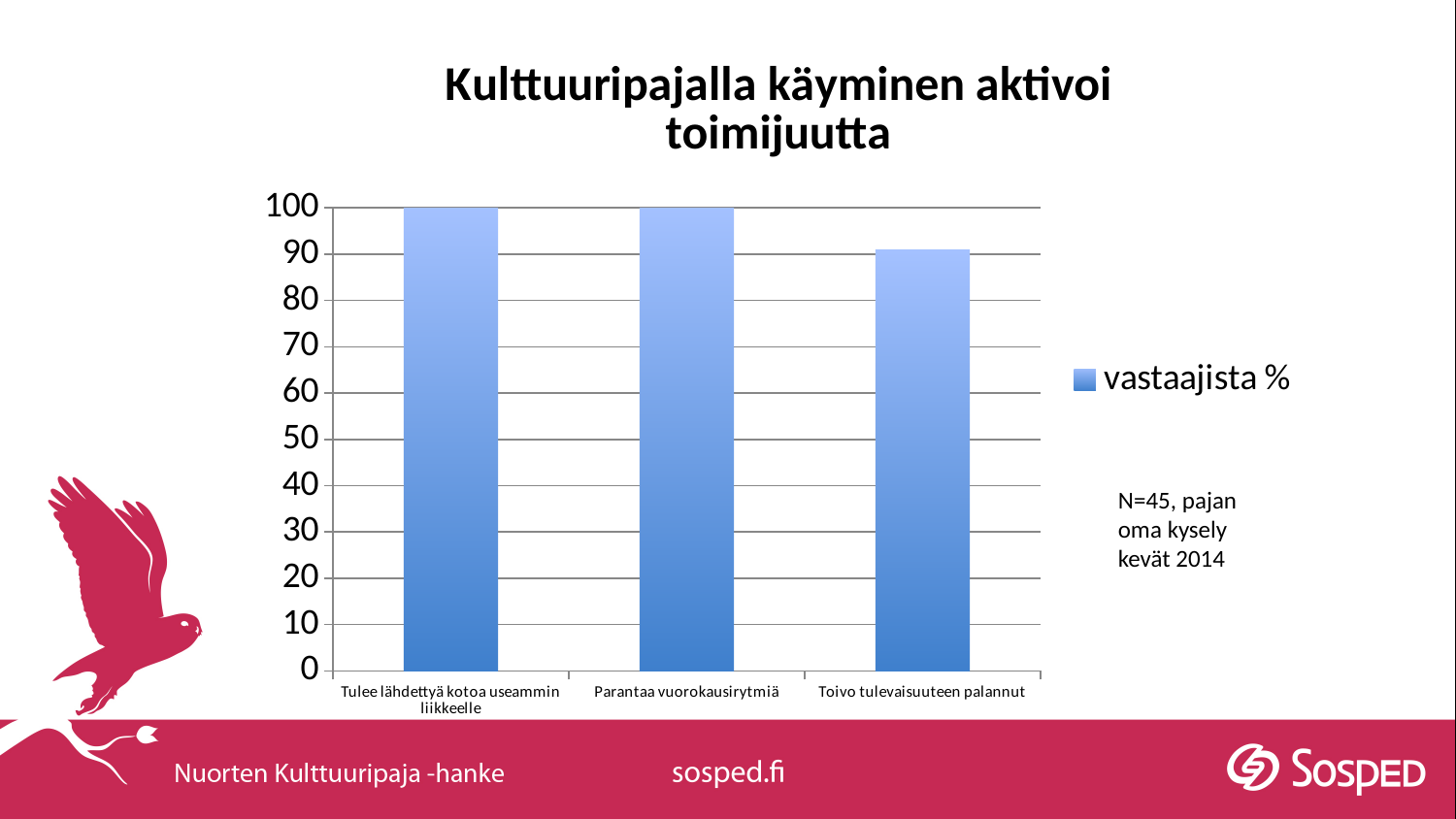
What is the title of the chart? Kulttuuripajalla käyminen aktivoi toimijuutta Which is larger, the value for 'Parantaa vuorokausirytmiä' or for 'Toivo tulevaisuuteen palannut'? Parantaa vuorokausirytmiä How many series does the legend list? 1 Which category has the lowest value? Toivo tulevaisuuteen palannut What is the value for 'Parantaa vuorokausirytmiä'? 100 Is the value for 'Toivo tulevaisuuteen palannut' greater or less than 80? greater What type of chart is shown on the slide? bar chart What is the value for 'Tulee lähdettyä kotoa useammin liikkeelle'? 100 What is the difference between the values for 'Tulee lähdettyä kotoa useammin liikkeelle' and 'Parantaa vuorokausirytmiä'? 0 What is the name of the series in the legend? vastaajista % Is the value for 'Toivo tulevaisuuteen palannut' greater or less than 100? less How many categories are shown on the x axis? 3